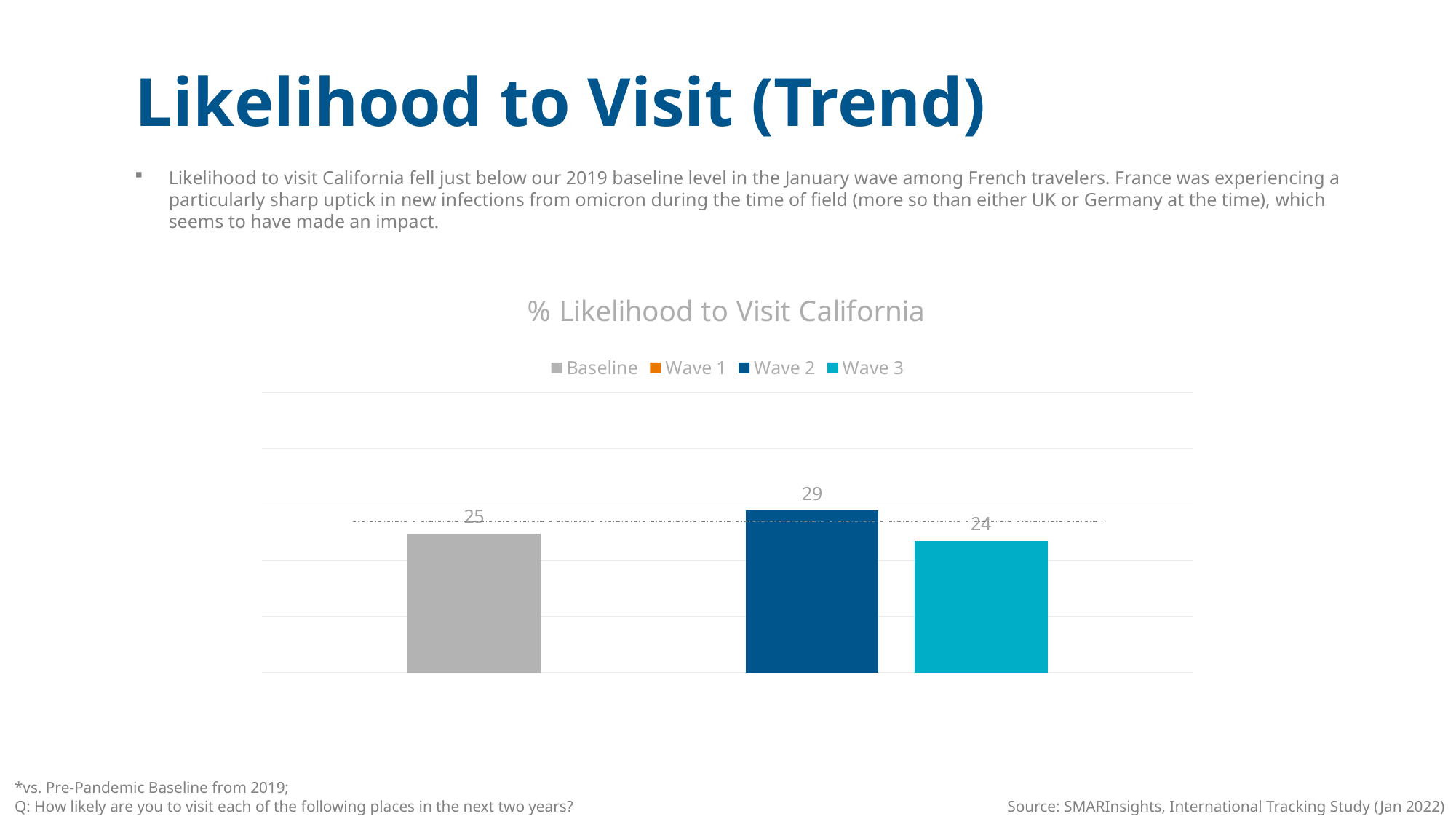
What is the value of the Wave 2 bar in the % Likelihood to Visit California chart? 29 Which series has the lowest value in the % Likelihood to Visit California chart? Wave 3 What is the value of the Wave 3 bar in the % Likelihood to Visit California chart? 24 What is the difference between the Wave 2 and Baseline values in the % Likelihood to Visit California chart? 4 What type of chart is shown on the slide? Bar chart Which series has the highest value in the % Likelihood to Visit California chart? Wave 2 How many bars are plotted in the % Likelihood to Visit California chart? 3 What is the difference between the Wave 2 and Wave 3 values in the % Likelihood to Visit California chart? 5 What is the title of the chart on the slide? % Likelihood to Visit California What is the value of the Baseline bar in the % Likelihood to Visit California chart? 25 How many series does the legend of the % Likelihood to Visit California chart list? 4 Which is larger in the % Likelihood to Visit California chart, the Baseline value or the Wave 3 value? Baseline